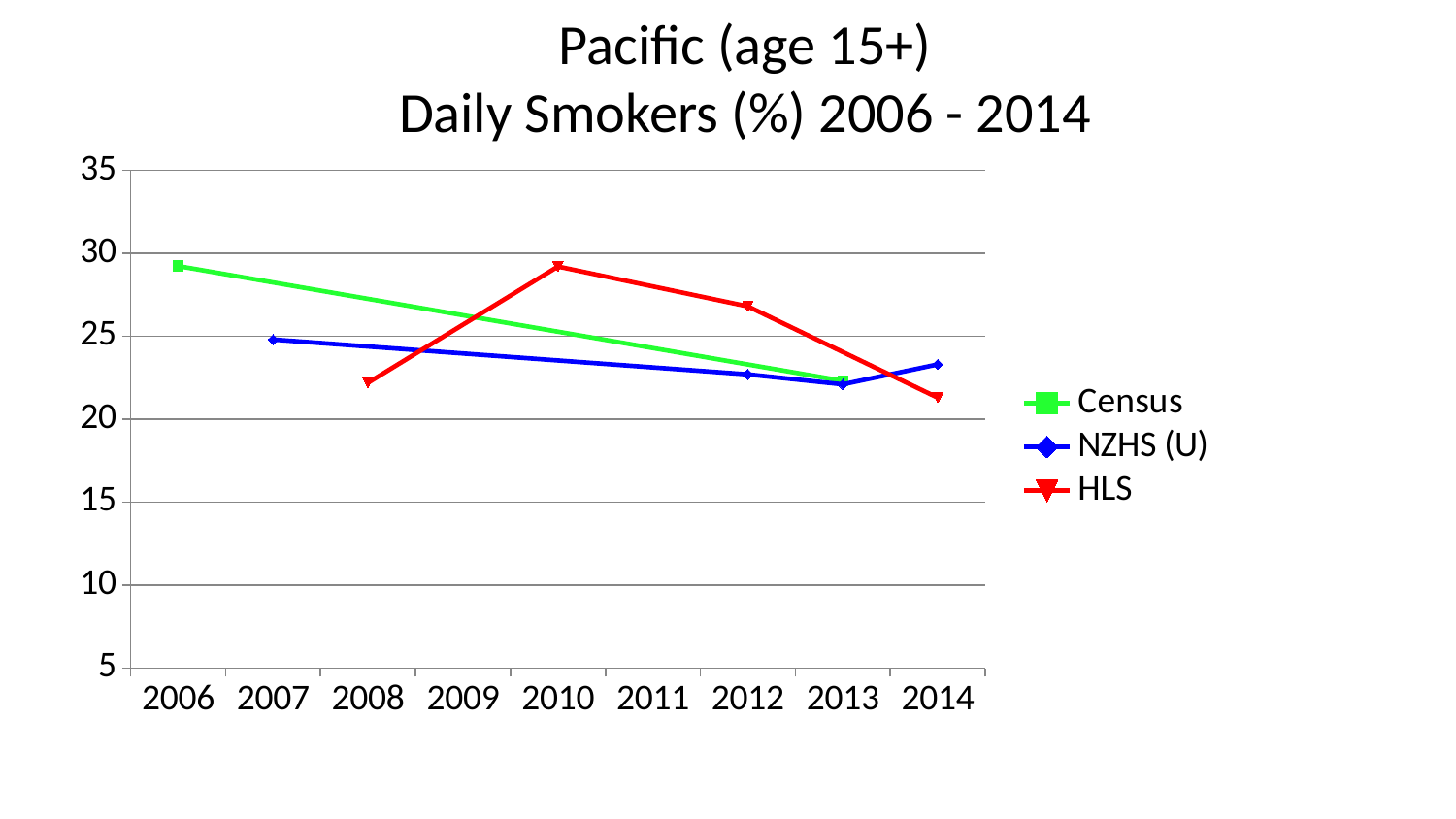
Which series is drawn in red? HLS Is the HLS value for 2014 greater or less than 25? less Which is larger in 2012, the HLS value or the NZHS (U) value? HLS Is the HLS value for 2010 greater or less than 25? greater What kind of chart is shown on the slide? line chart How many series does the legend list? 3 Is the Census value for 2006 greater or less than 25? greater How many years are labelled on the x axis? 9 In which year does the HLS series reach its highest value? 2010 Does the Census series rise or fall between 2006 and 2013? fall In which year does the HLS series reach its lowest value? 2014